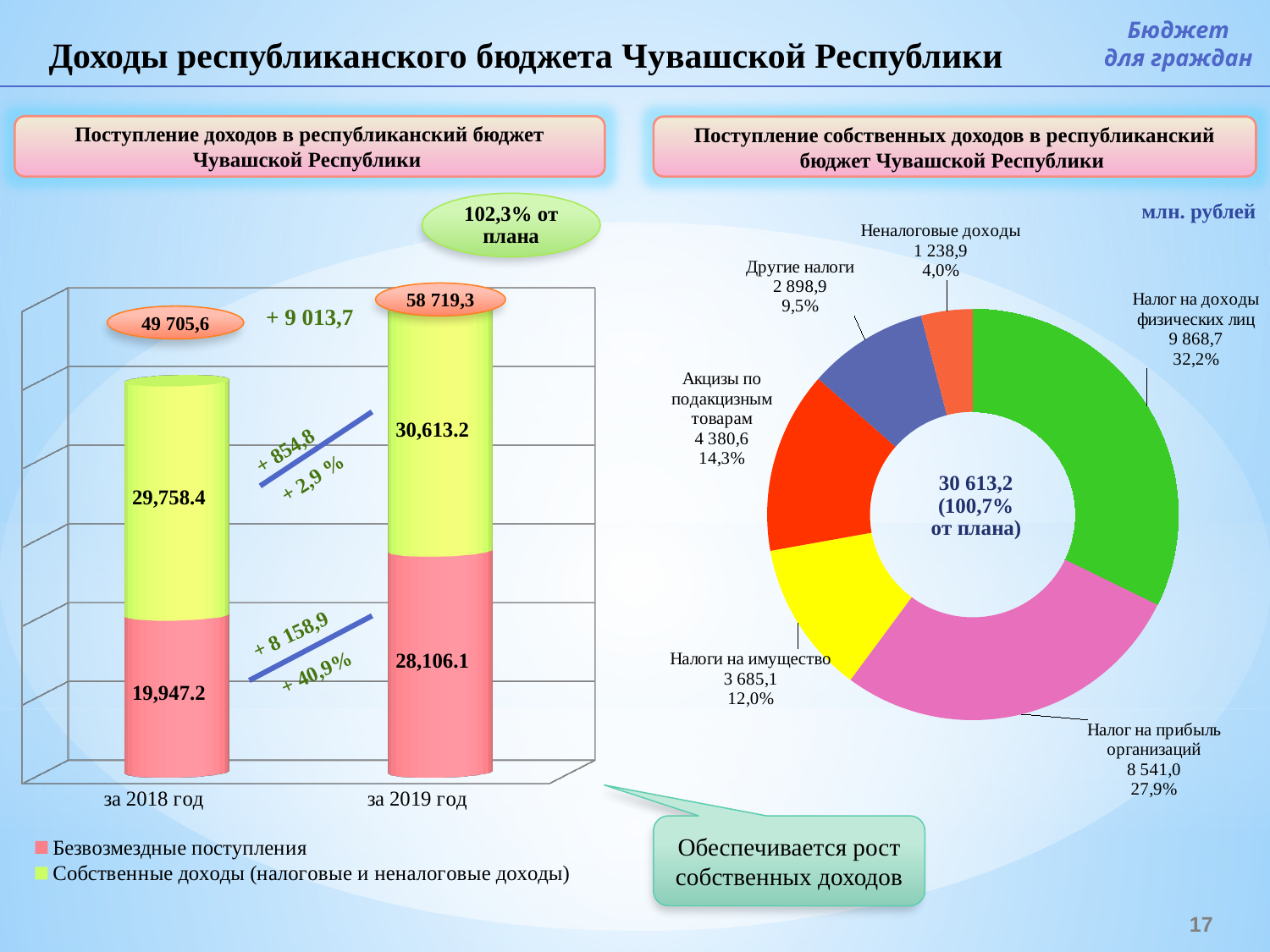
On the left chart (Поступление доходов в республиканский бюджет Чувашской Республики), what is the value of Безвозмездные поступления for за 2019 год? 28,106.1 On the left chart, what is the total of the stacked bar for за 2019 год? 58 719,3 On the right chart (Поступление собственных доходов в республиканский бюджет Чувашской Республики), what is the value for Налог на прибыль организаций? 8 541,0 On the left chart, what is the total of the stacked bar for за 2018 год? 49 705,6 On the left chart, which is larger: Безвозмездные поступления for за 2018 год or for за 2019 год? за 2019 год On the right chart, what share does Акцизы по подакцизным товарам have? 14,3% On the right chart, which category has the largest share? Налог на доходы физических лиц On the right chart, which category has the smallest share? Неналоговые доходы On the left chart, what is the value of Собственные доходы for за 2018 год? 29,758.4 On the left chart, what kind of chart is shown? Stacked bar chart On the right chart, how many categories are shown? 6 On the left chart, how many series does the legend list? 2